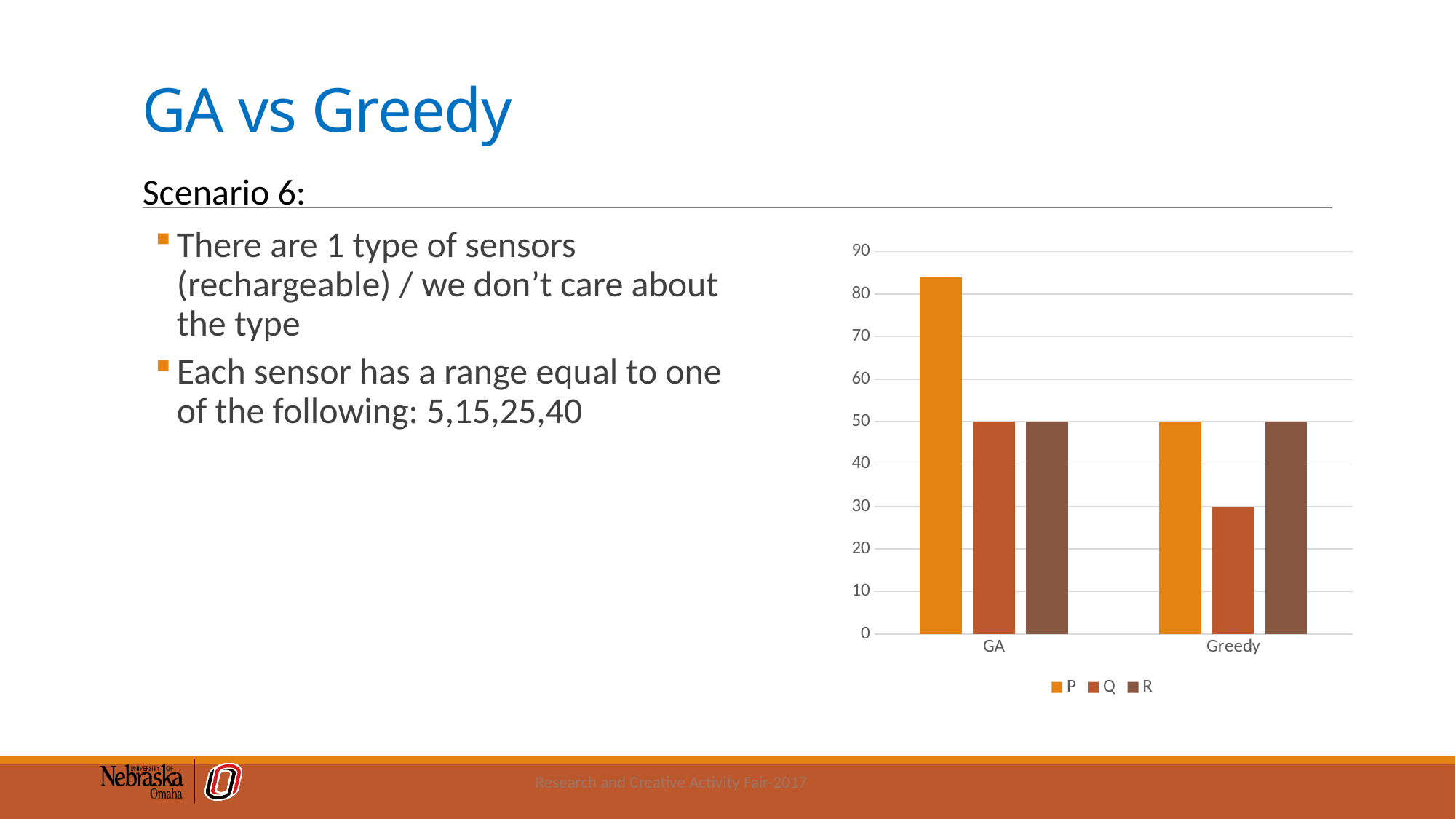
Which category has the larger value for P, GA or Greedy? GA Is the value of P for GA greater or less than 90? less What is the difference between the value of Q for GA and the value of Q for Greedy? 20 Which series has the lowest value for Greedy? Q How many categories are shown on the x axis of the chart? 2 What kind of chart is shown on the slide? bar chart How many series does the chart's legend list? 3 Which series has the highest value for GA? P What is the value of Q for Greedy? 30 Is the value of P for GA greater or less than 80? greater What is the value of Q for GA? 50 What are the series names listed in the chart's legend? P, Q, R